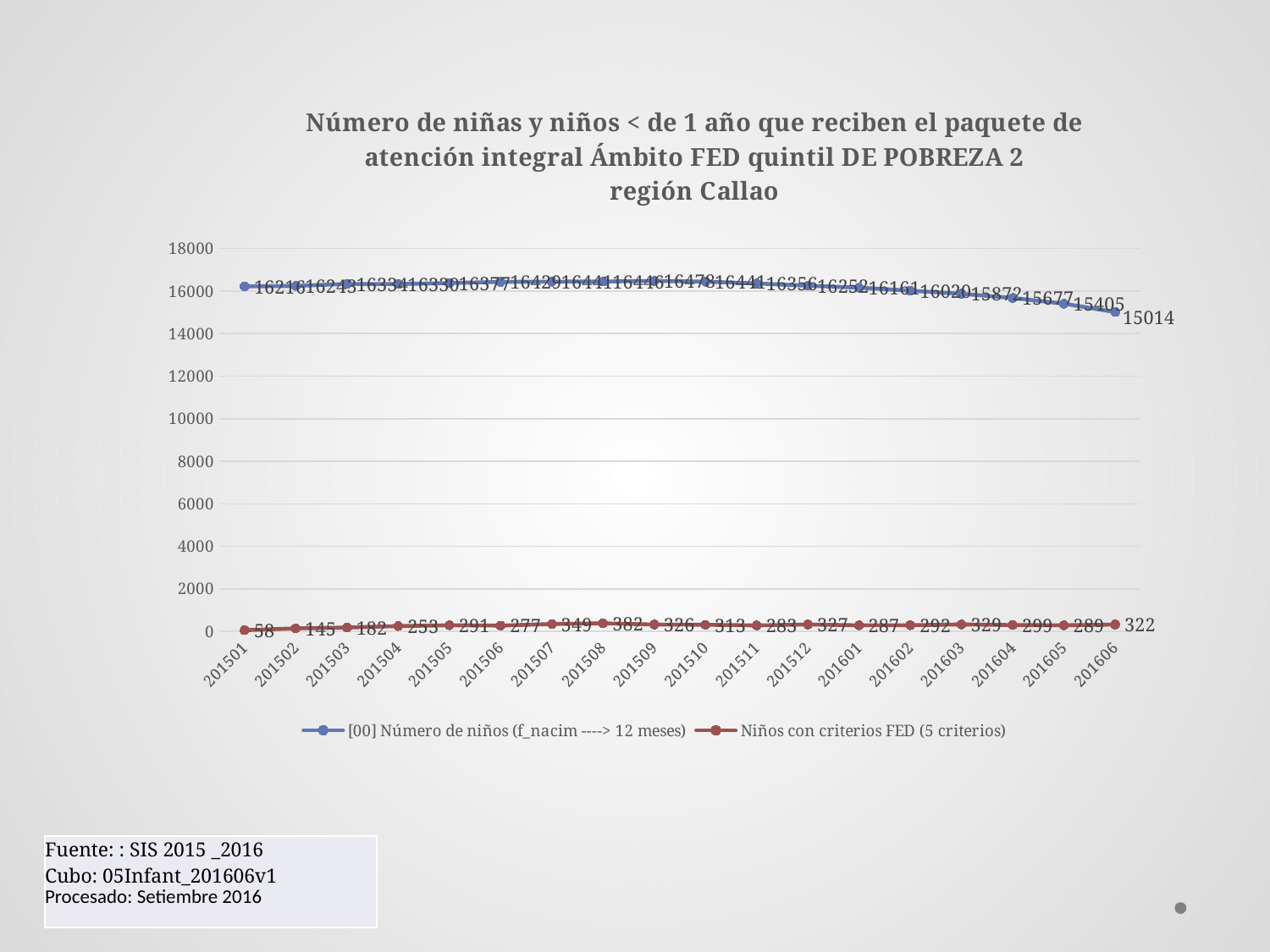
In which period is 'Niños con criterios FED (5 criterios)' highest? 201508 Which period has the larger 'Niños con criterios FED (5 criterios)' value, 201507 or 201509? 201507 In which period is 'Niños con criterios FED (5 criterios)' lowest? 201501 What is the value of '[00] Número de niños (f_nacim ----> 12 meses)' for 201606? 15014 What is the value of 'Niños con criterios FED (5 criterios)' for 201508? 382 How many time periods are plotted along the x axis? 18 What is the difference between the 'Niños con criterios FED (5 criterios)' values for 201508 and 201501? 324 How many series does the legend list? 2 Does the '[00] Número de niños (f_nacim ----> 12 meses)' series rise or fall from 201601 to 201606? fall What is the value of 'Niños con criterios FED (5 criterios)' for 201501? 58 What kind of chart is shown on the slide? line chart Is the value of '[00] Número de niños (f_nacim ----> 12 meses)' for 201501 greater or less than 16000? greater